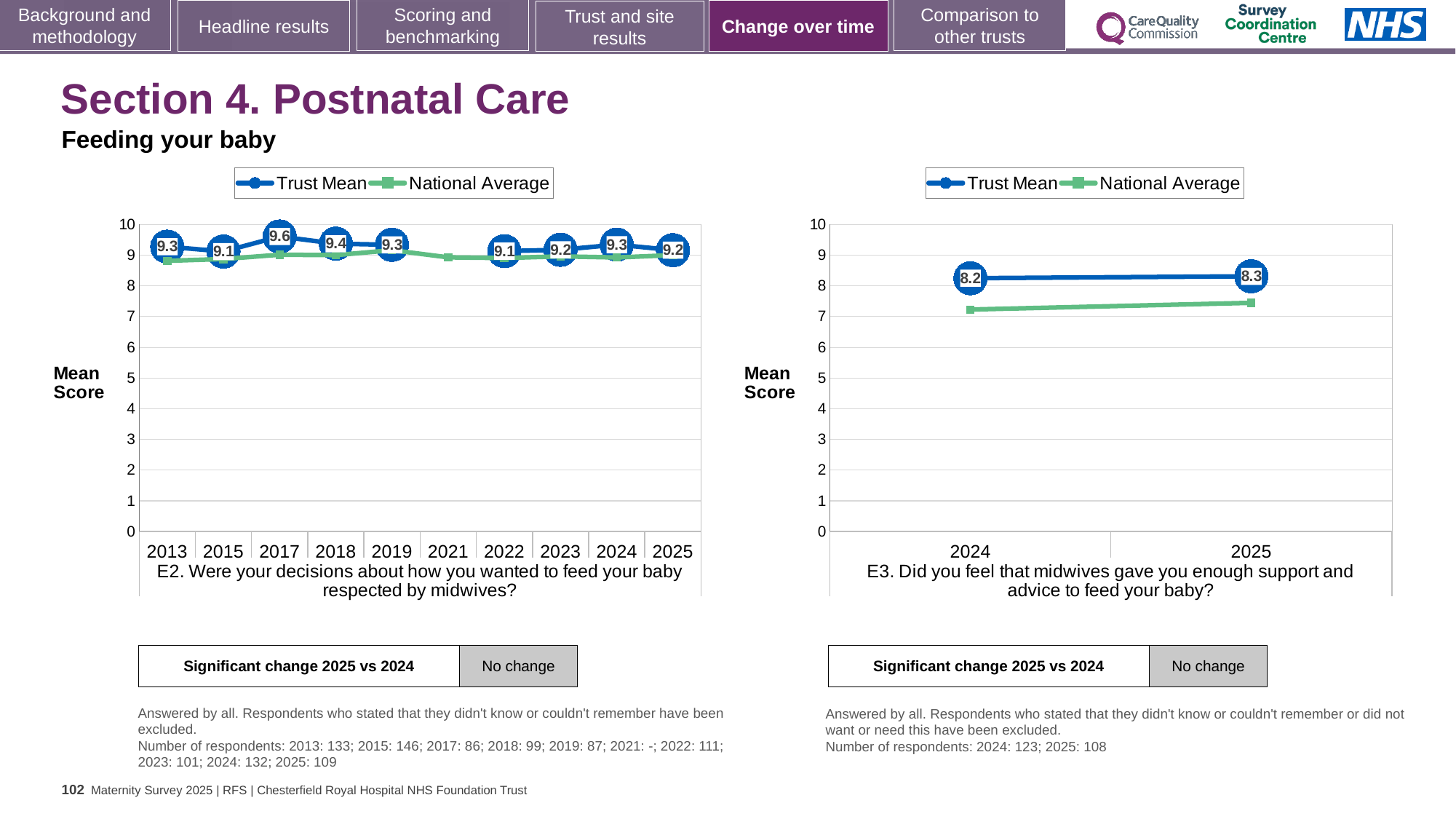
What kind of chart is the right chart (E3)? Line chart On the left chart (E2), what is the difference between the Trust Mean in 2017 and in 2015? 0.5 On the right chart (E3), how many series does the legend list? 2 On the right chart (E3), is the National Average for 2024 greater or less than 8? less On the right chart (E3), what is the Trust Mean for 2024? 8.2 On the left chart (E2), what is the lowest Trust Mean value shown? 9.1 On the right chart (E3), which is larger in 2025, the Trust Mean or the National Average? Trust Mean On the left chart (E2), what is the Trust Mean for 2017? 9.6 On the left chart (E2), how many years are shown on the x axis? 10 On the right chart (E3), does the Trust Mean rise or fall from 2024 to 2025? Rises On the left chart (E2), in which year is the Trust Mean highest? 2017 On the left chart (E2), what is the Trust Mean for 2025? 9.2